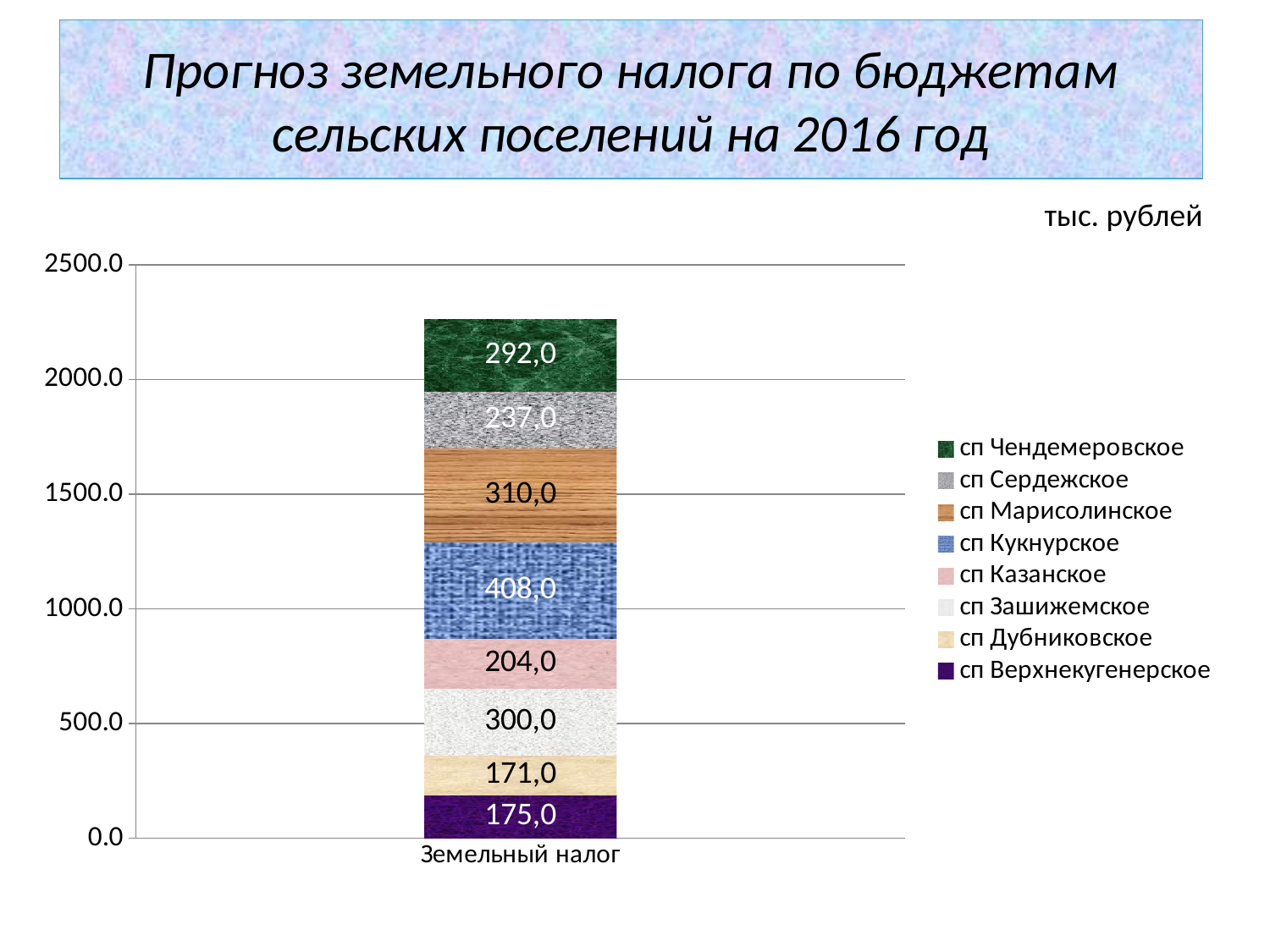
What is the value for сп Чендемеровское? 292,0 What type of chart is shown on the slide? stacked bar chart What is the total of the stacked bar for Земельный налог? 2097,0 Is the total height of the stacked bar greater or less than 2500? less What unit is indicated above the chart? тыс. рублей What is the value for сп Кукнурское? 408,0 What is the value for сп Дубниковское? 171,0 Which settlement has the highest land tax forecast? сп Кукнурское What is the difference between the values for сп Марисолинское and сп Сердежское? 73,0 Which is larger, the value for сп Зашижемское or the value for сп Казанское? сп Зашижемское Which settlement has the lowest land tax forecast? сп Дубниковское How many series does the legend list? 8